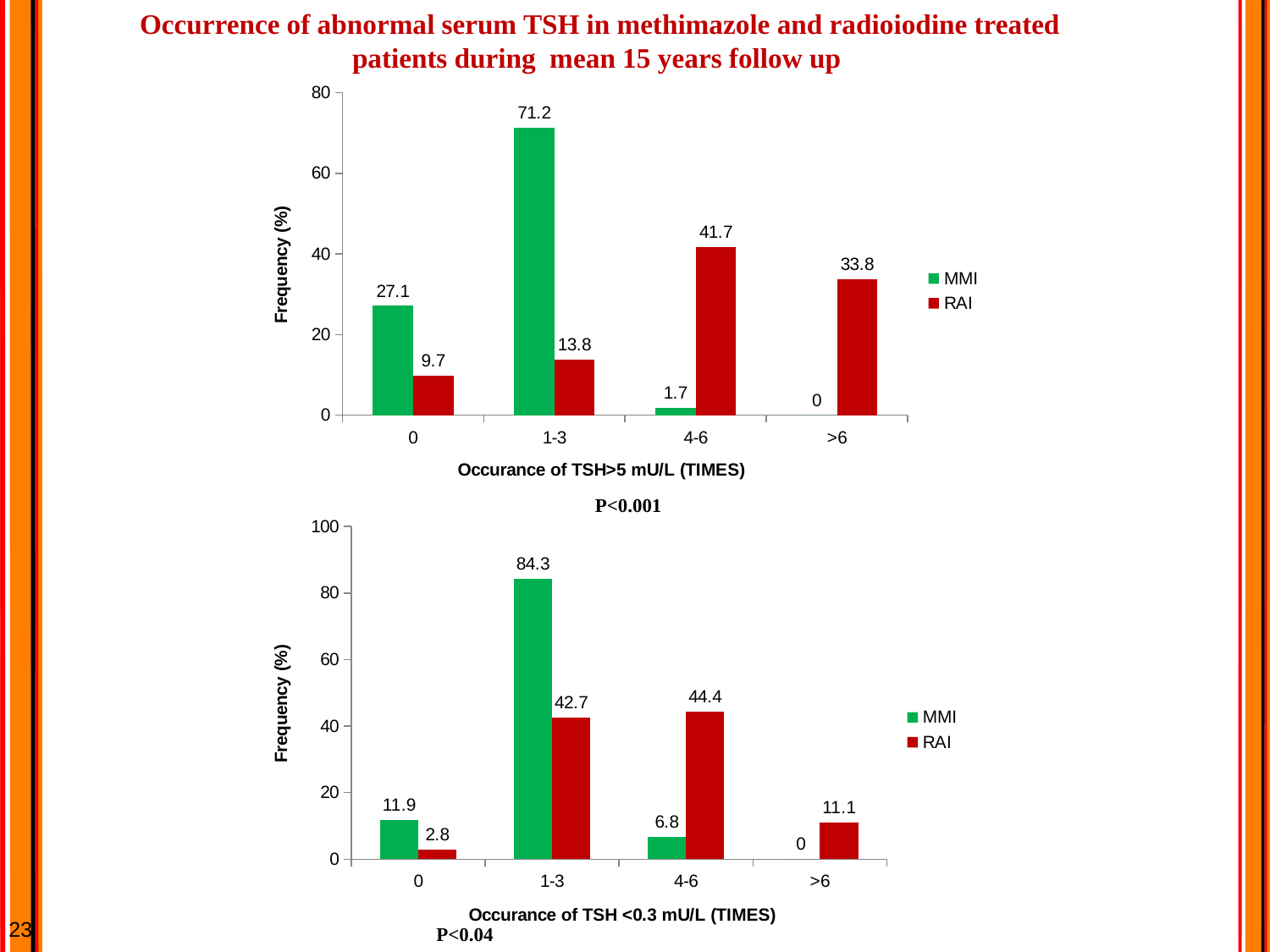
In the bottom chart (Occurance of TSH <0.3 mU/L), what is the difference between the MMI and RAI values for the 1-3 category? 41.6 What type of chart is the bottom chart (Occurance of TSH <0.3 mU/L)? Bar chart How many categories are shown on the x axis of the bottom chart (Occurance of TSH <0.3 mU/L)? 4 In the top chart (Occurance of TSH>5 mU/L), which category has the highest RAI value? 4-6 In the top chart (Occurance of TSH>5 mU/L), what is the difference between the MMI and RAI values for the 0 category? 17.4 How many series does the legend of the top chart (Occurance of TSH>5 mU/L) list? 2 In the top chart (Occurance of TSH>5 mU/L), which is larger for the 4-6 category, MMI or RAI? RAI In the bottom chart (Occurance of TSH <0.3 mU/L), which category has the lowest RAI value? 0 In the top chart (Occurance of TSH>5 mU/L), what is the MMI value for the 1-3 category? 71.2 In the top chart (Occurance of TSH>5 mU/L), what is the RAI value for the >6 category? 33.8 In the bottom chart (Occurance of TSH <0.3 mU/L), what is the RAI value for the 4-6 category? 44.4 In the bottom chart (Occurance of TSH <0.3 mU/L), what is the MMI value for the 0 category? 11.9